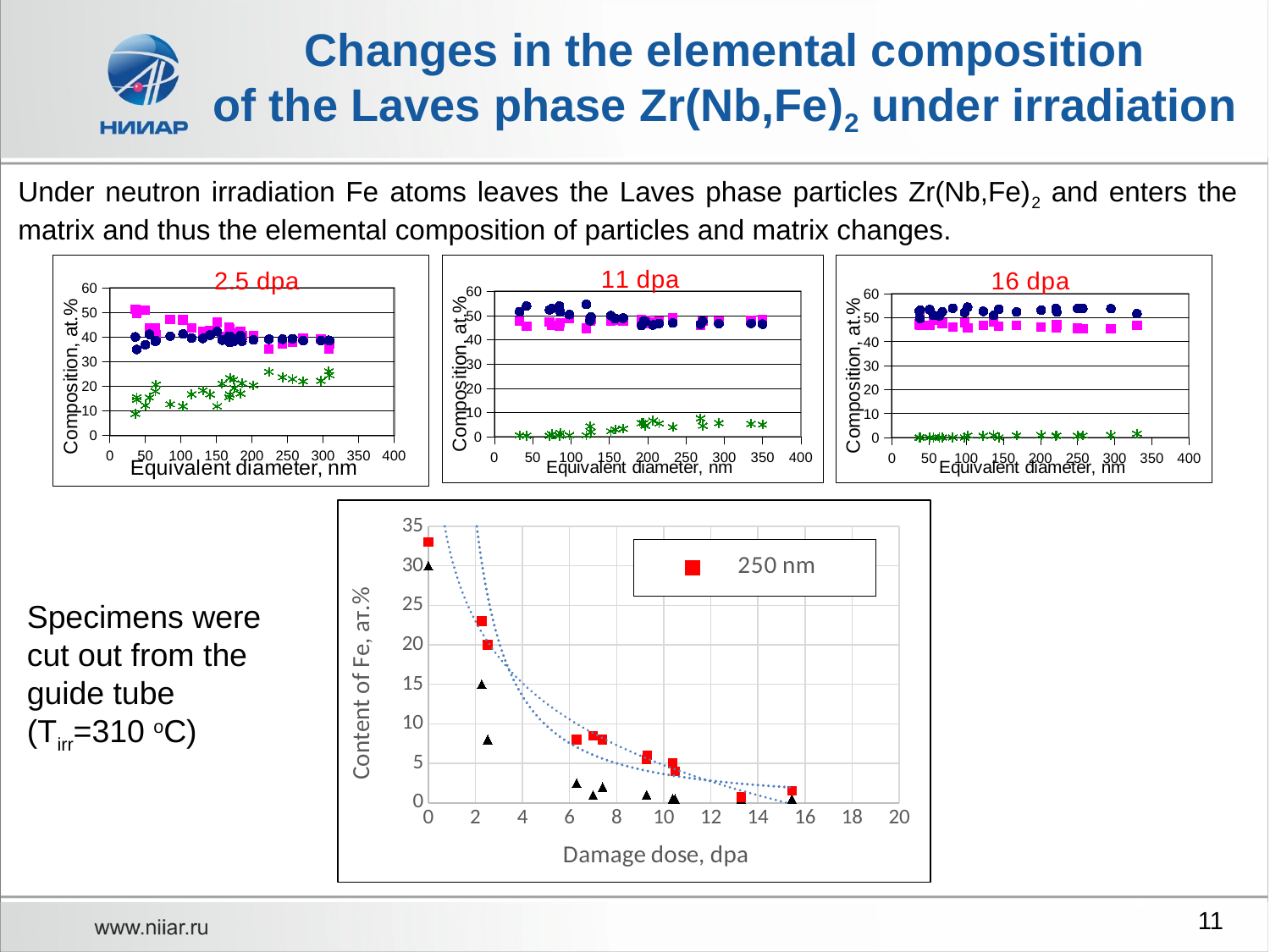
In the bottom chart, is the red square value at 0 dpa greater or less than 30? greater In the bottom chart, what is the legend entry for the red square markers? 250 nm In the bottom chart, is the red square value at about 15.5 dpa greater or less than 5? less In the bottom chart, does the content of Fe rise or fall as the damage dose increases? fall In the '11 dpa' chart, are the blue circle values greater or less than 40? greater In the bottom chart, how many series does the legend list? 1 In the '2.5 dpa' chart, do the green star values rise or fall as the equivalent diameter increases? rise What kind of chart is the bottom chart with 'Damage dose, dpa' on the x axis? scatter chart How many charts in the top row share the x-axis label 'Equivalent diameter, nm'? 3 What is the x-axis title of the bottom chart? Damage dose, dpa